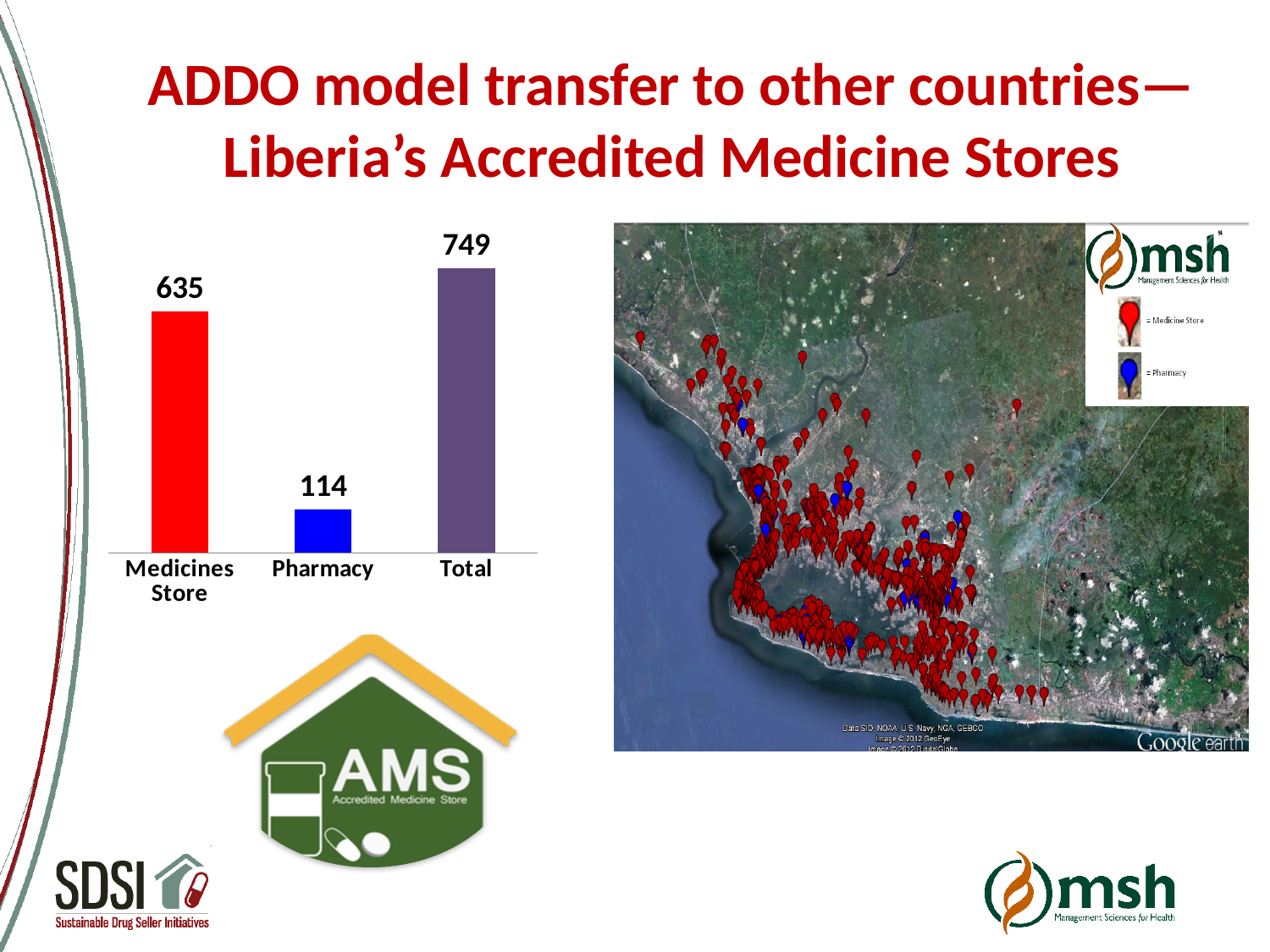
How many categories are shown in the bar chart? 3 What is the difference between the Medicines Store value and the Pharmacy value? 521 Which is larger, the value for Medicines Store or the value for Pharmacy? Medicines Store What kind of chart is shown on the slide? Bar chart What colour is the Pharmacy bar in the chart? Blue What is the value for Pharmacy in the bar chart? 114 What is the value for Total in the bar chart? 749 Which category has the highest value in the bar chart? Total What colour is the Medicines Store bar in the chart? Red Which category has the lowest value in the bar chart? Pharmacy What is the value for Medicines Store in the bar chart? 635